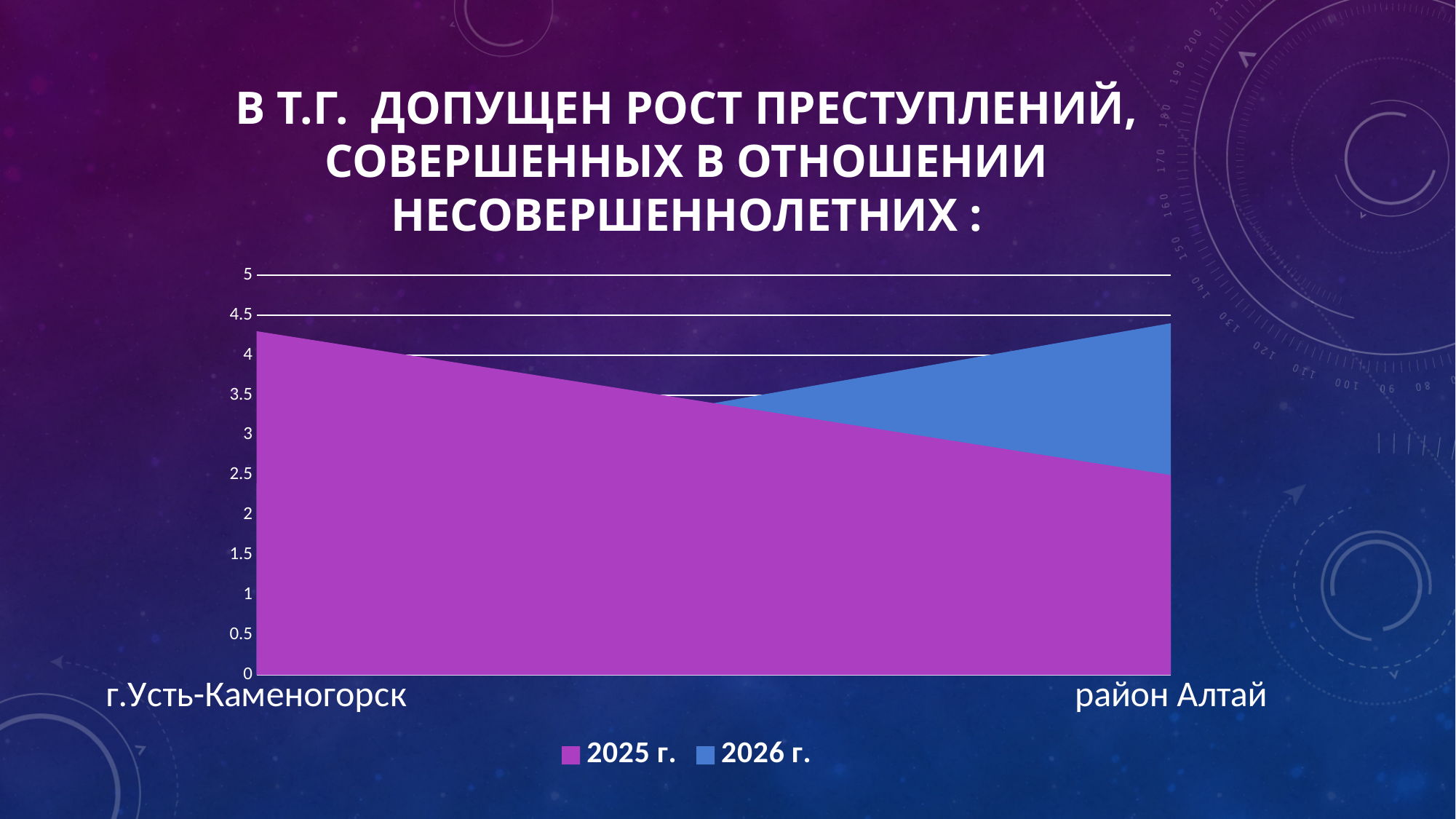
What kind of chart is shown on the slide? area chart For the 2025 г. series, which category has the higher value? г.Усть-Каменогорск Is the 2026 г. value for район Алтай greater or less than 4? greater Which colour represents the 2025 г. series? purple Is the 2025 г. value for район Алтай greater or less than 3? less For район Алтай, which series has the larger value, 2025 г. or 2026 г.? 2026 г. How many series does the legend list? 2 For the 2025 г. series, which category has the lower value? район Алтай How many categories are shown on the x axis? 2 Is the 2025 г. value for г.Усть-Каменогорск greater or less than 4? greater Does the 2025 г. series rise or fall from г.Усть-Каменогорск to район Алтай? fall Which two series are listed in the legend? 2025 г. and 2026 г.